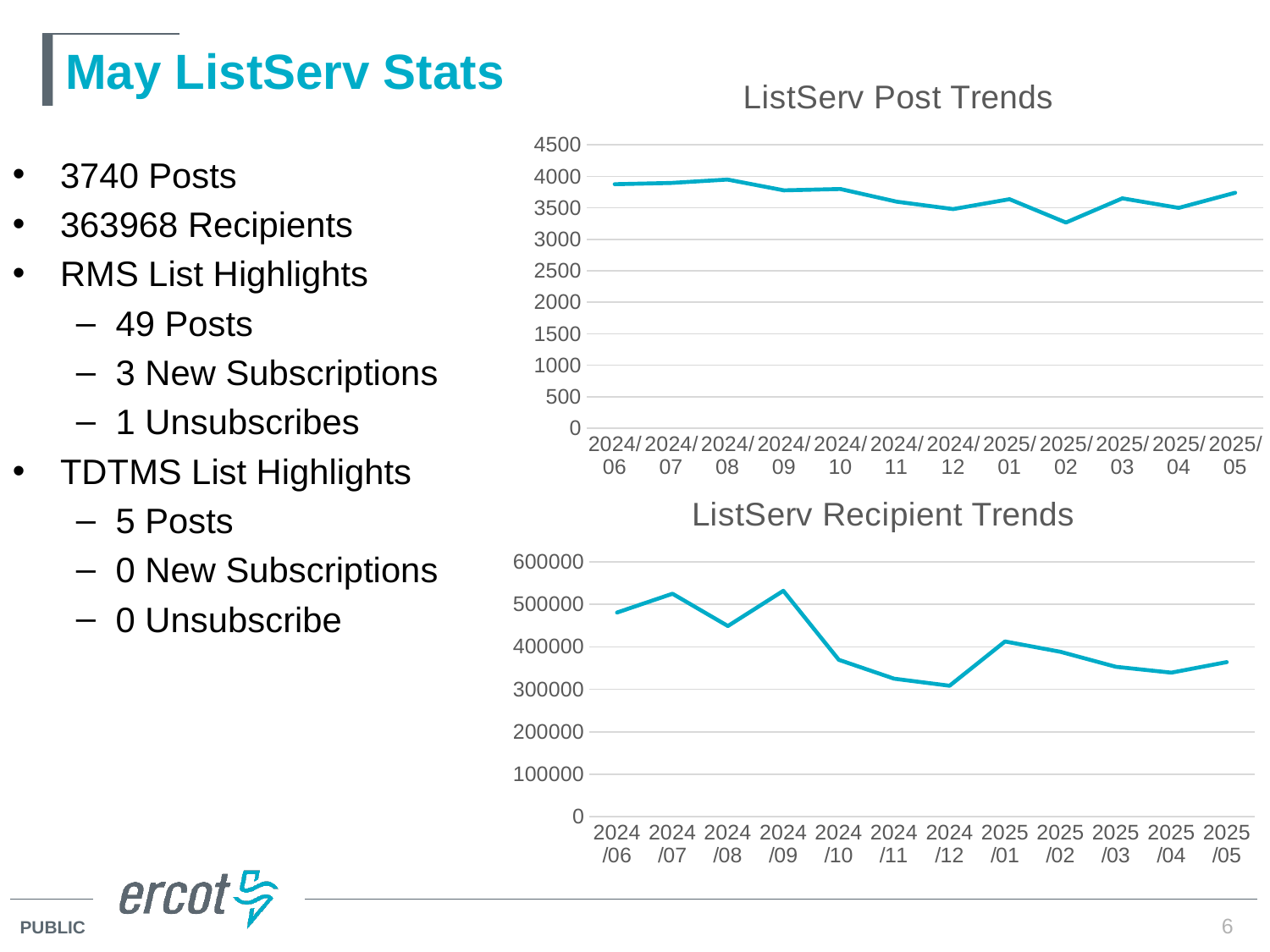
On the "ListServ Recipient Trends" chart, which is larger, the value for 2024/07 or the value for 2024/11? 2024/07 On the "ListServ Recipient Trends" chart, which month has the lowest value? 2024/12 On the "ListServ Recipient Trends" chart, is the value for 2024/12 greater or less than 400000? less On the "ListServ Post Trends" chart, is the value for 2025/02 greater or less than 3500? less On the "ListServ Recipient Trends" chart, is the value for 2024/09 greater or less than 500000? greater On the "ListServ Recipient Trends" chart, do the values rise or fall from 2024/09 to 2024/12? fall How many months are plotted on the "ListServ Recipient Trends" chart? 12 On the "ListServ Post Trends" chart, which is larger, the value for 2024/06 or the value for 2025/02? 2024/06 What is the title of the upper chart on the slide? ListServ Post Trends What kind of chart is the "ListServ Post Trends" chart? line chart On the "ListServ Post Trends" chart, which month has the lowest value? 2025/02